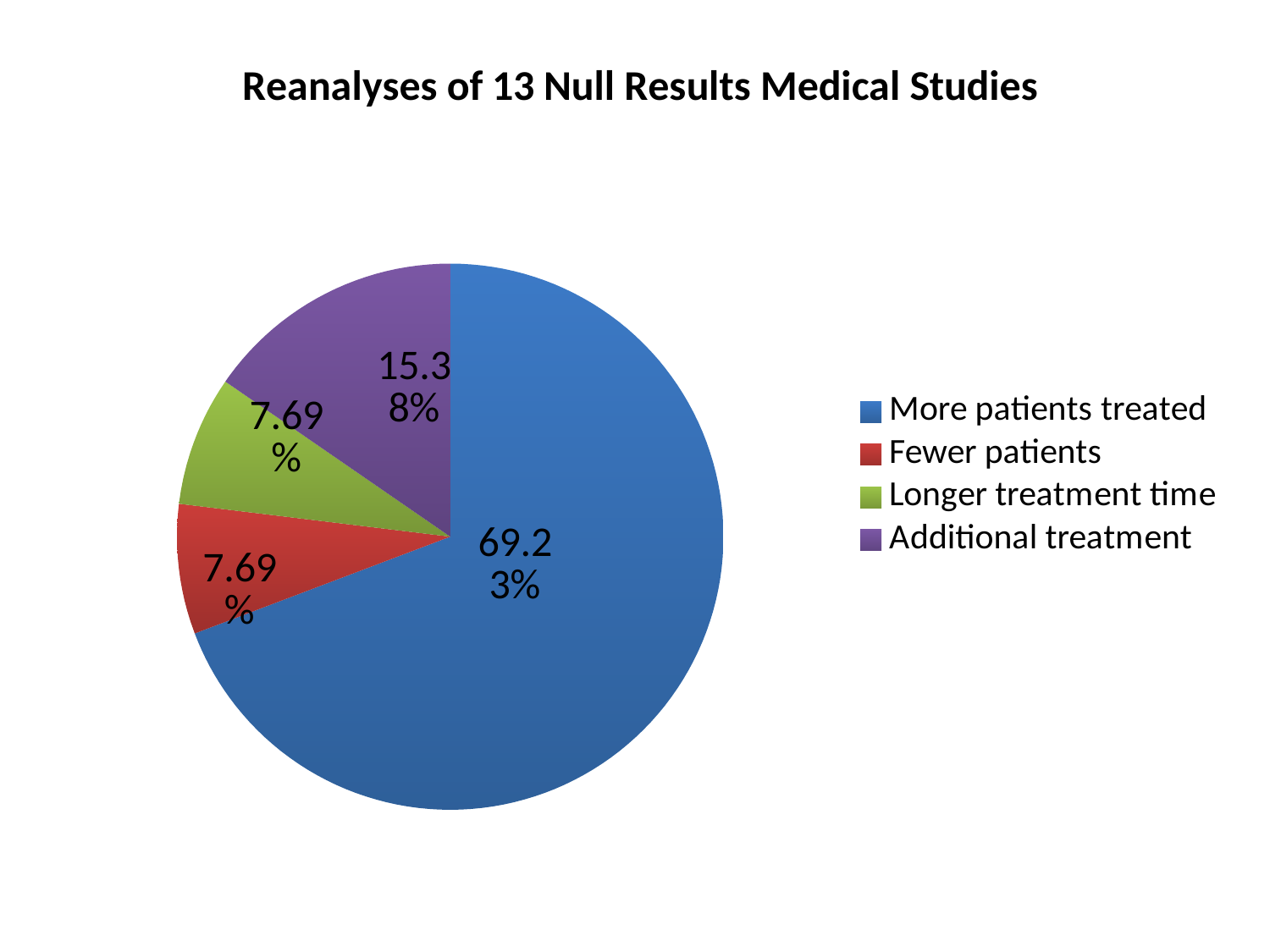
What percentage is shown for Fewer patients? 7.69% What is the difference in percentage points between Additional treatment and Fewer patients? 7.69 What type of chart is shown on the slide? Pie chart What percentage is shown for Longer treatment time? 7.69% What is the difference in percentage points between More patients treated and Additional treatment? 53.85 Which category has the largest slice of the pie? More patients treated What percentage is shown for Additional treatment? 15.38% Which is larger, the slice for Additional treatment or the slice for Longer treatment time? Additional treatment Which two categories share the smallest slice of the pie? Fewer patients and Longer treatment time How many slices does the pie chart have? 4 What share of the pie does More patients treated account for? 69.23% What is the title of the chart? Reanalyses of 13 Null Results Medical Studies